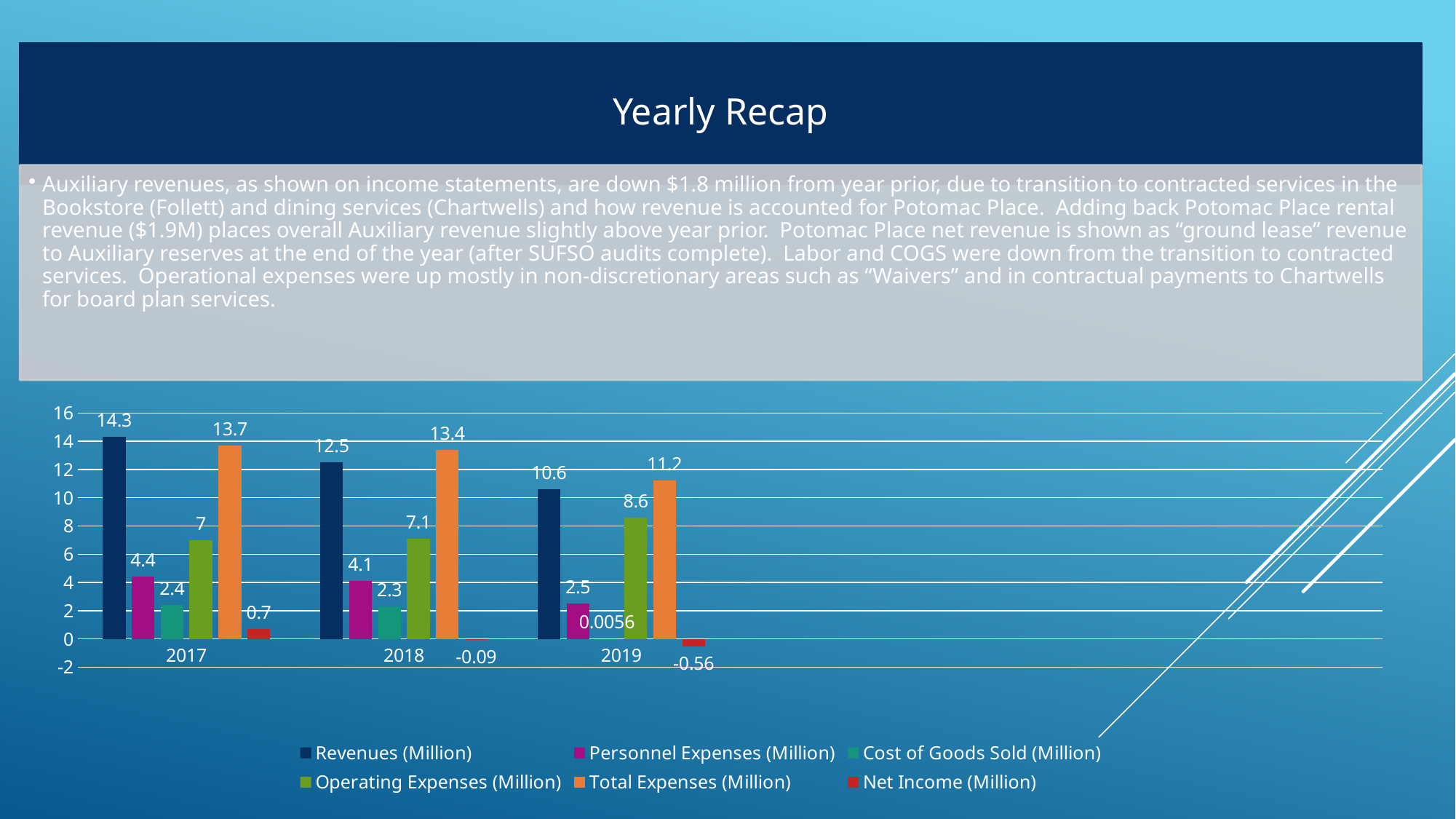
How many series does the chart legend list? 6 What is the difference between Revenues (Million) in 2017 and 2019? 3.7 What kind of chart is shown on the slide? bar chart In which year is Revenues (Million) the highest? 2017 What is the value of Net Income (Million) for 2018? -0.09 Does Operating Expenses (Million) rise or fall from 2017 to 2019? rise What is the value of Total Expenses (Million) for 2019? 11.2 In which year is Personnel Expenses (Million) the lowest? 2019 What is the value of Revenues (Million) for 2017? 14.3 What is the value of Cost of Goods Sold (Million) for 2019? 0.0056 How many years are shown on the x axis of the chart? 3 Which is larger in 2018: Revenues (Million) or Total Expenses (Million)? Total Expenses (Million)